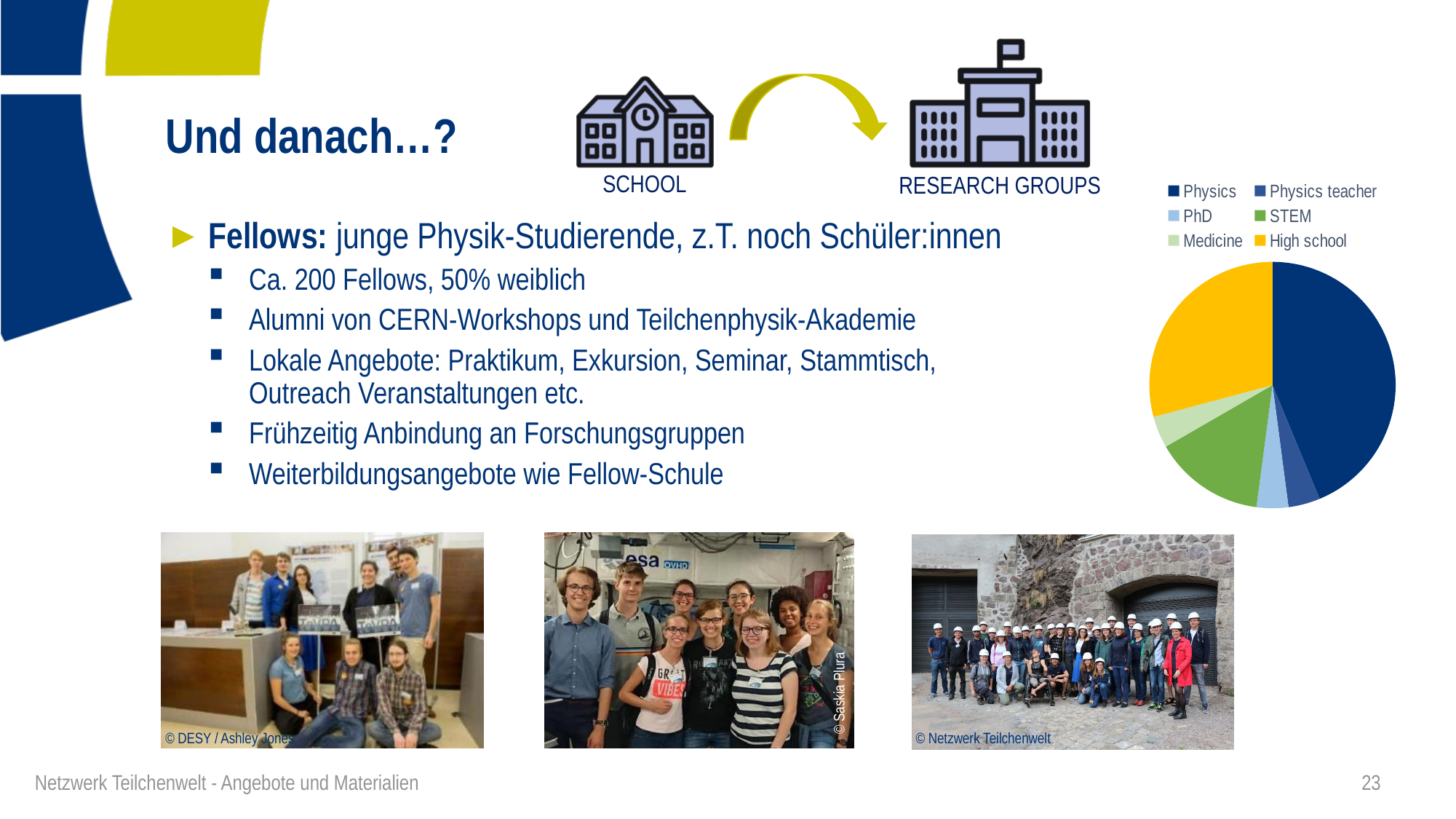
Which legend entry of the pie chart is shown in dark blue? Physics How many entries does the legend of the pie chart list? 6 How many slices does the pie chart have? 6 In the pie chart, which slice is larger: STEM or Medicine? STEM In the pie chart, which slice is larger: Physics or STEM? Physics Which category has the largest slice in the pie chart? Physics What colour is the High school slice in the pie chart? yellow In the pie chart, which slice is larger: High school or STEM? High school What kind of chart is shown on the right side of the slide? pie chart